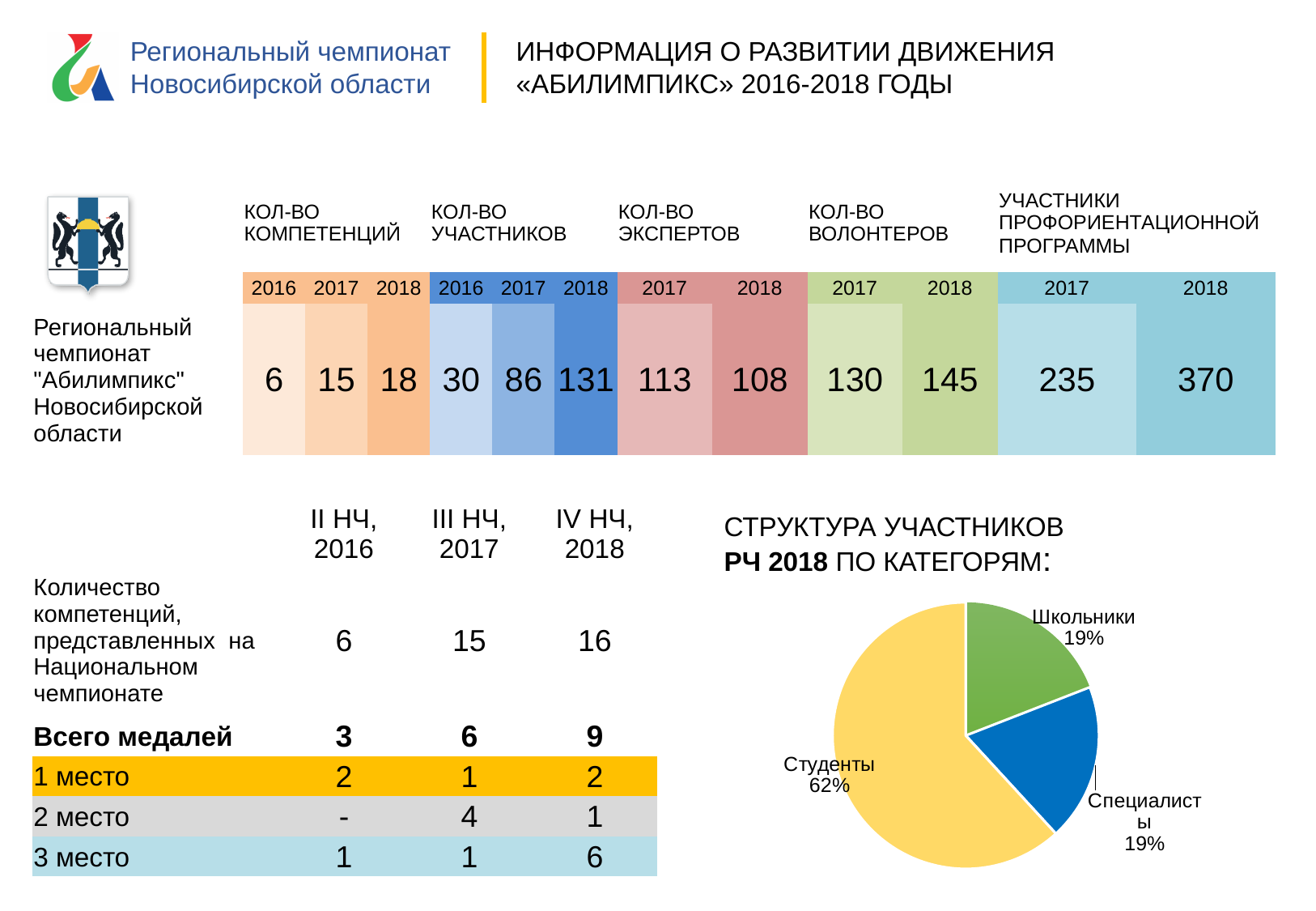
Which is larger in the pie chart, Студенты or Школьники? Студенты Is the share of Студенты in the pie chart greater or less than 50%? greater Which category has the largest slice in the pie chart? Студенты What share of the pie chart is Специалисты? 19% What is the difference between the shares of Студенты and Специалисты in the pie chart? 43% What is the title of the pie chart? СТРУКТУРА УЧАСТНИКОВ РЧ 2018 ПО КАТЕГОРЯМ What colour is the Студенты slice in the pie chart? yellow What kind of chart is shown on the slide? pie chart What share of the pie chart is Школьники? 19% What share of the pie chart is Студенты? 62% How many categories does the pie chart show? 3 What is the combined share of Школьники and Специалисты in the pie chart? 38%